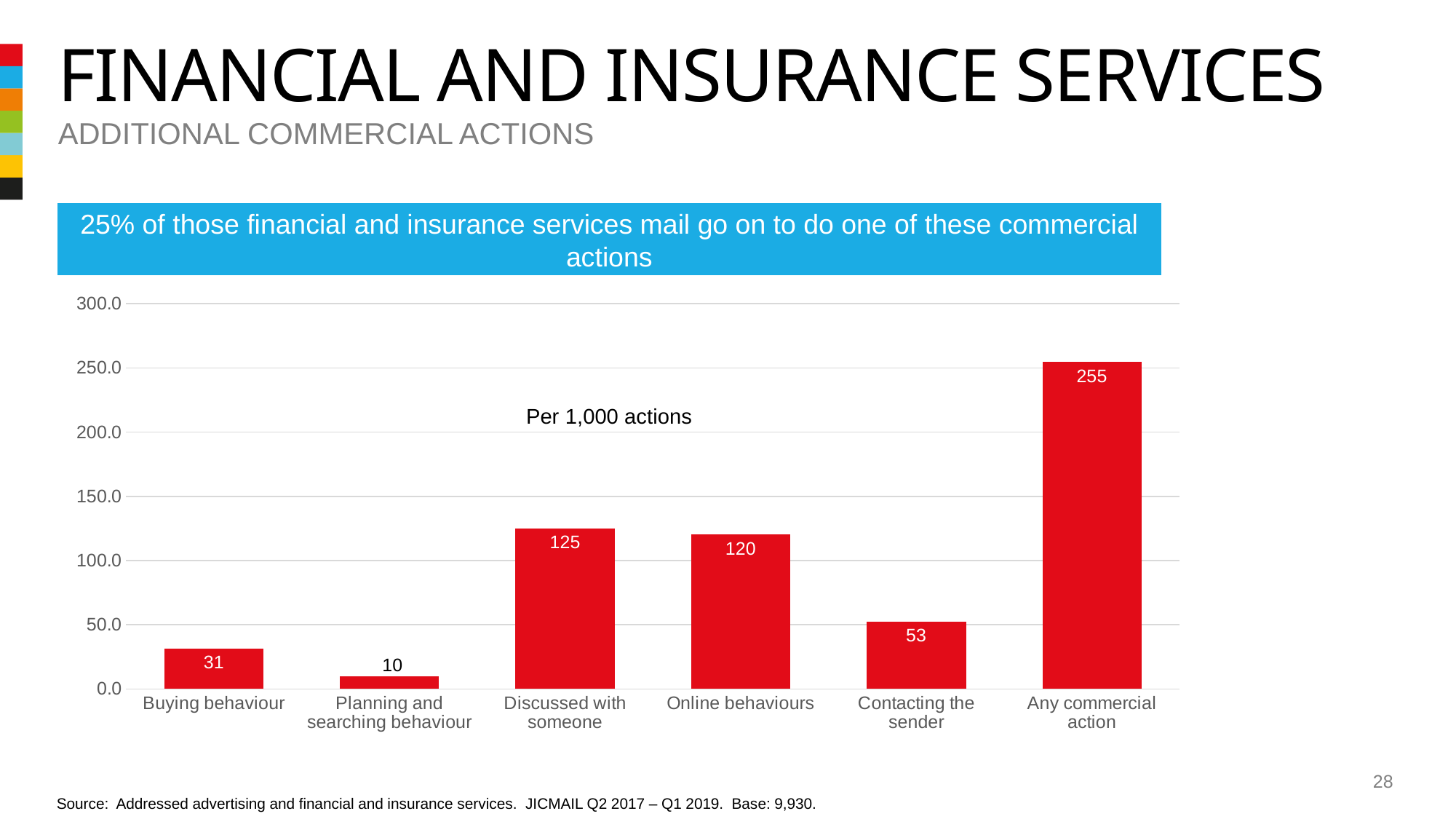
Is the value for Online behaviours greater or less than 100? greater What is the value for Planning and searching behaviour? 10 Which is larger, Online behaviours or Contacting the sender? Online behaviours What is the difference between Any commercial action and Discussed with someone? 130 What is the value for Discussed with someone? 125 What is the value for Buying behaviour? 31 What is the text label shown inside the chart area above the bars? Per 1,000 actions How many categories are shown on the x axis? 6 Which category has the lowest value? Planning and searching behaviour Which category has the highest value? Any commercial action What kind of chart is shown on the slide? Bar chart What is the value for Contacting the sender? 53